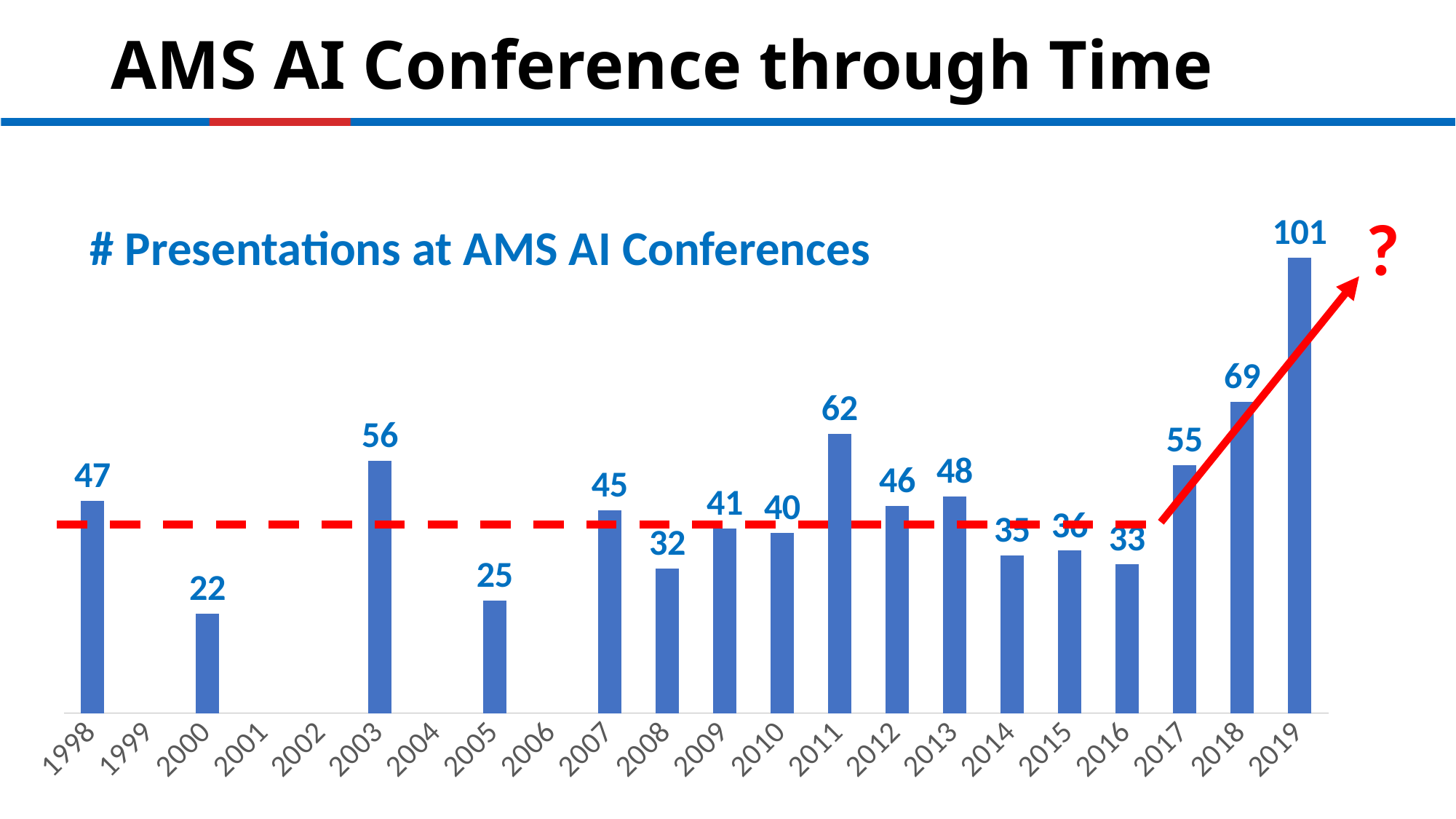
What is the title of the chart? # Presentations at AMS AI Conferences What is the number of presentations shown for 2019? 101 Which year had more presentations, 2017 or 2013? 2017 Do the number of presentations rise or fall from 2016 to 2019? Rise What kind of chart is shown on the slide? Bar chart What is the number of presentations shown for 2000? 22 What is the difference in presentations between 2019 and 2018? 32 What is the number of presentations shown for 2003? 56 What is the number of presentations shown for 2011? 62 Which year has the highest number of presentations? 2019 How many years on the x axis have a bar plotted? 17 Which year has the lowest number of presentations among the years with bars? 2000